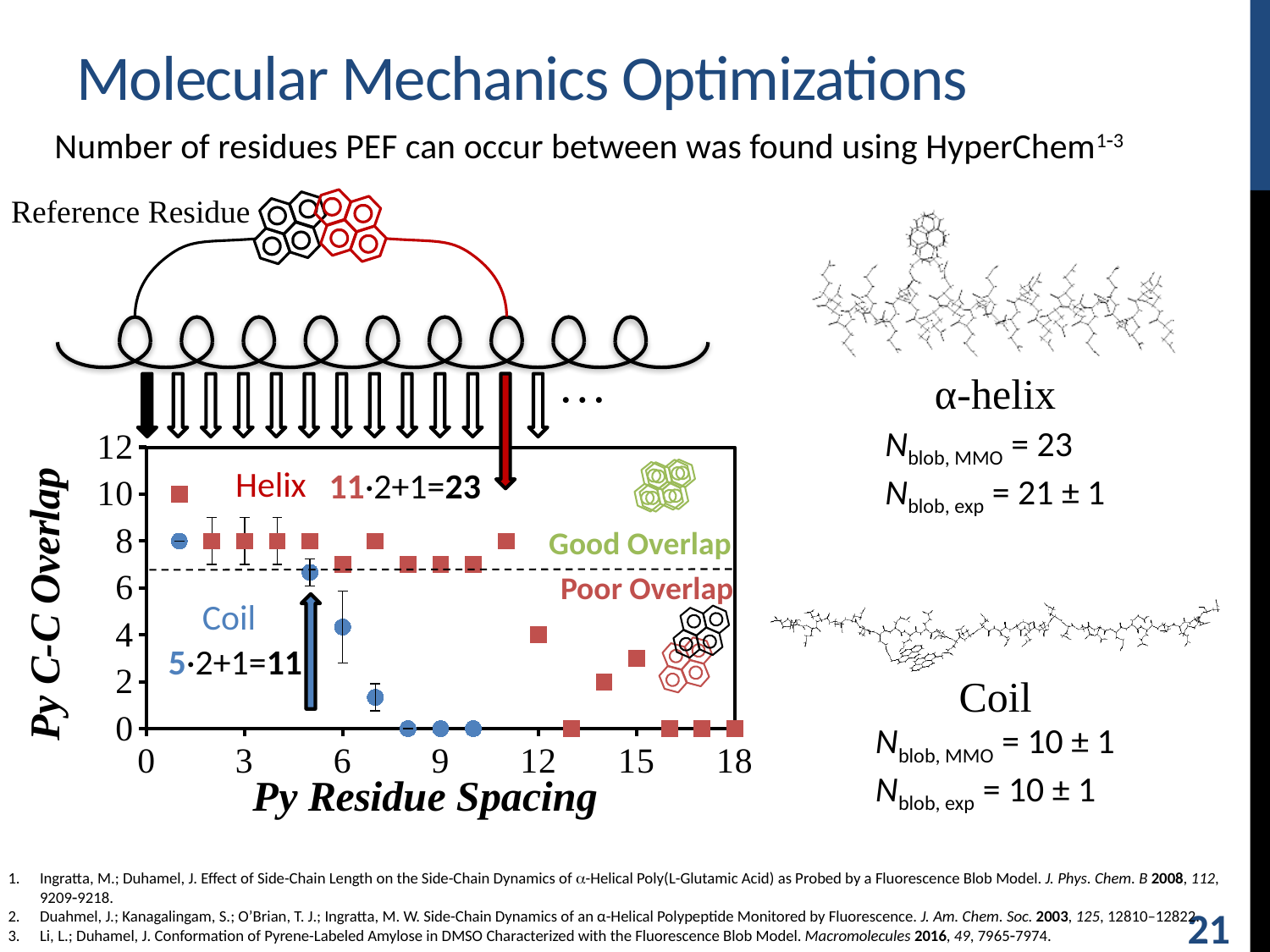
What is the Coil value at a Py residue spacing of 9? 0 What is the title of the y axis of the chart? Py C-C Overlap Is the Coil value at a Py residue spacing of 6 greater or less than 6? less What kind of chart is shown on the slide? scatter chart At a Py residue spacing of 7, which series has the larger Py C-C overlap, Helix or Coil? Helix Is the Coil value at a Py residue spacing of 7 greater or less than 2? less Is the Helix value at a Py residue spacing of 2 greater or less than 6? greater What is the title of the x axis of the chart? Py Residue Spacing How many data series are plotted in the chart? 2 Do the Coil values rise or fall as the Py residue spacing increases? fall